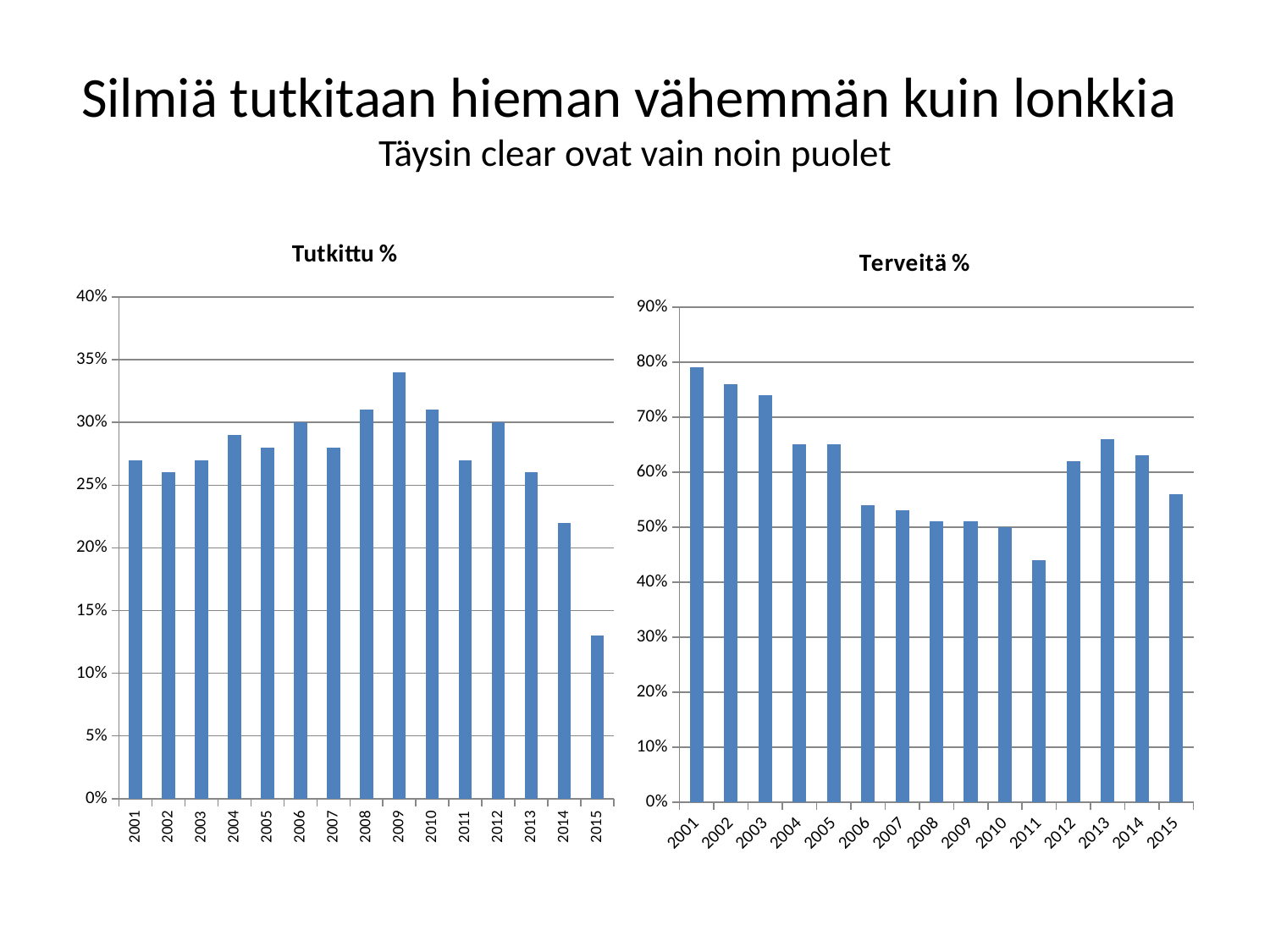
In the "Tutkittu %" chart, which year has the highest value? 2009 In the "Tutkittu %" chart, do the values rise or fall from 2012 to 2015? fall In the "Terveitä %" chart, which year has the larger value, 2002 or 2013? 2002 In the "Terveitä %" chart, which year has the lowest value? 2011 What kind of chart is the "Tutkittu %" chart? bar chart How many years are shown on the x axis of the "Terveitä %" chart? 15 In the "Tutkittu %" chart, which year has the lowest value? 2015 In the "Tutkittu %" chart, is the value for 2015 greater or less than 15%? less In the "Terveitä %" chart, which year has the highest value? 2001 In the "Tutkittu %" chart, which year has the larger value, 2009 or 2014? 2009 In the "Terveitä %" chart, is the value for 2001 greater or less than 70%? greater In the "Terveitä %" chart, is the value for 2011 greater or less than 50%? less